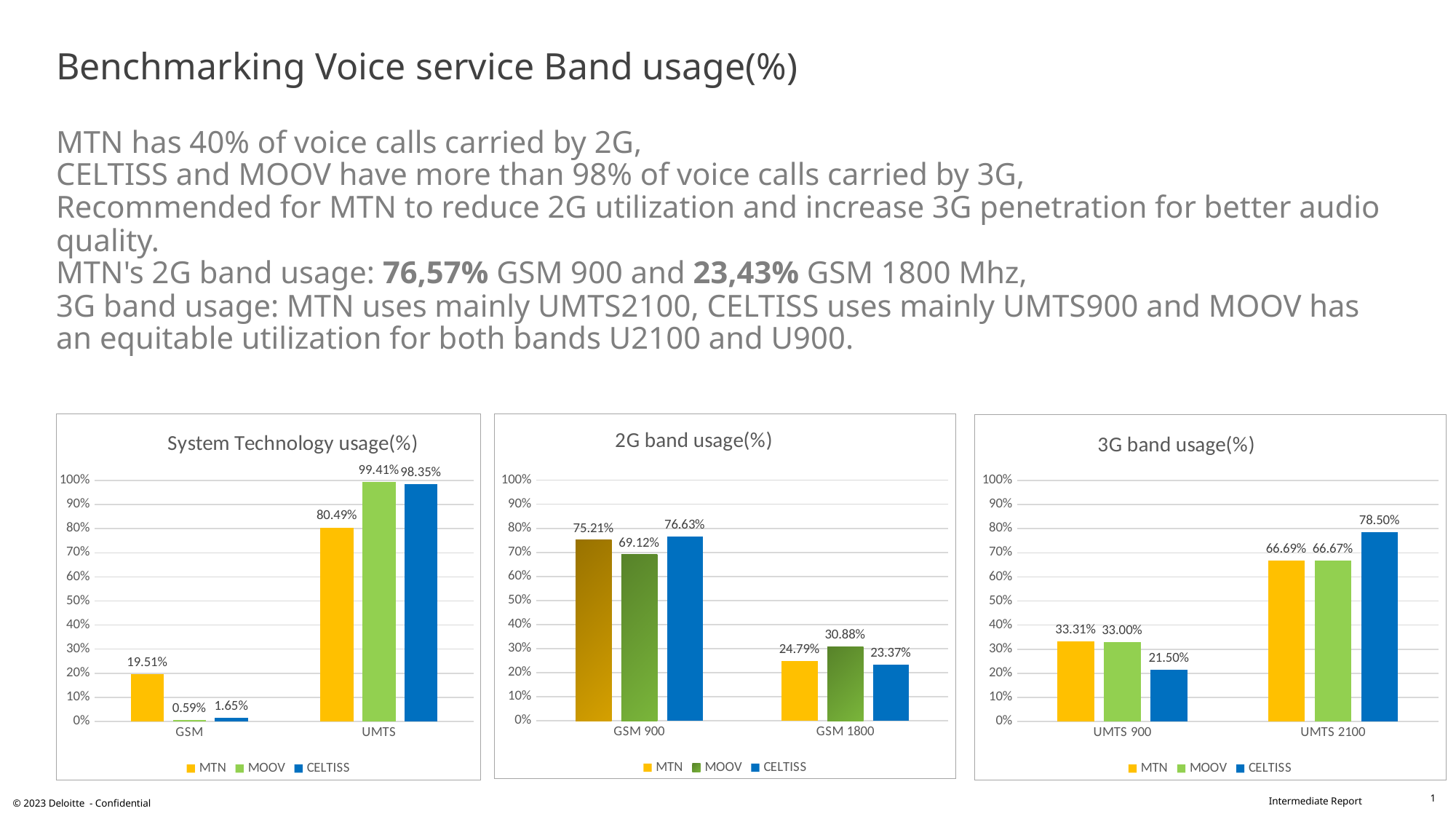
How many categories are shown on the x axis of the 'System Technology usage(%)' chart? 2 In the 'System Technology usage(%)' chart, which operator has the highest value under UMTS? MOOV In the '2G band usage(%)' chart, which operator has the lowest value under GSM 1800? CELTISS In the 'System Technology usage(%)' chart, what is the value for MTN under GSM? 19.51% In the '2G band usage(%)' chart, what is the value for CELTISS under GSM 900? 76.63% In the '3G band usage(%)' chart, which operator has the lowest value under UMTS 900? CELTISS In the '2G band usage(%)' chart, which is larger under GSM 900: MTN or MOOV? MTN In the '3G band usage(%)' chart, what is the value for CELTISS under UMTS 2100? 78.50% What kind of chart is the '3G band usage(%)' chart? Bar chart In the 'System Technology usage(%)' chart, what is the difference between the MTN values for UMTS and GSM? 60.98% In the '3G band usage(%)' chart, what is the difference between the CELTISS values for UMTS 2100 and UMTS 900? 57.00% How many series does the legend of the '2G band usage(%)' chart list? 3